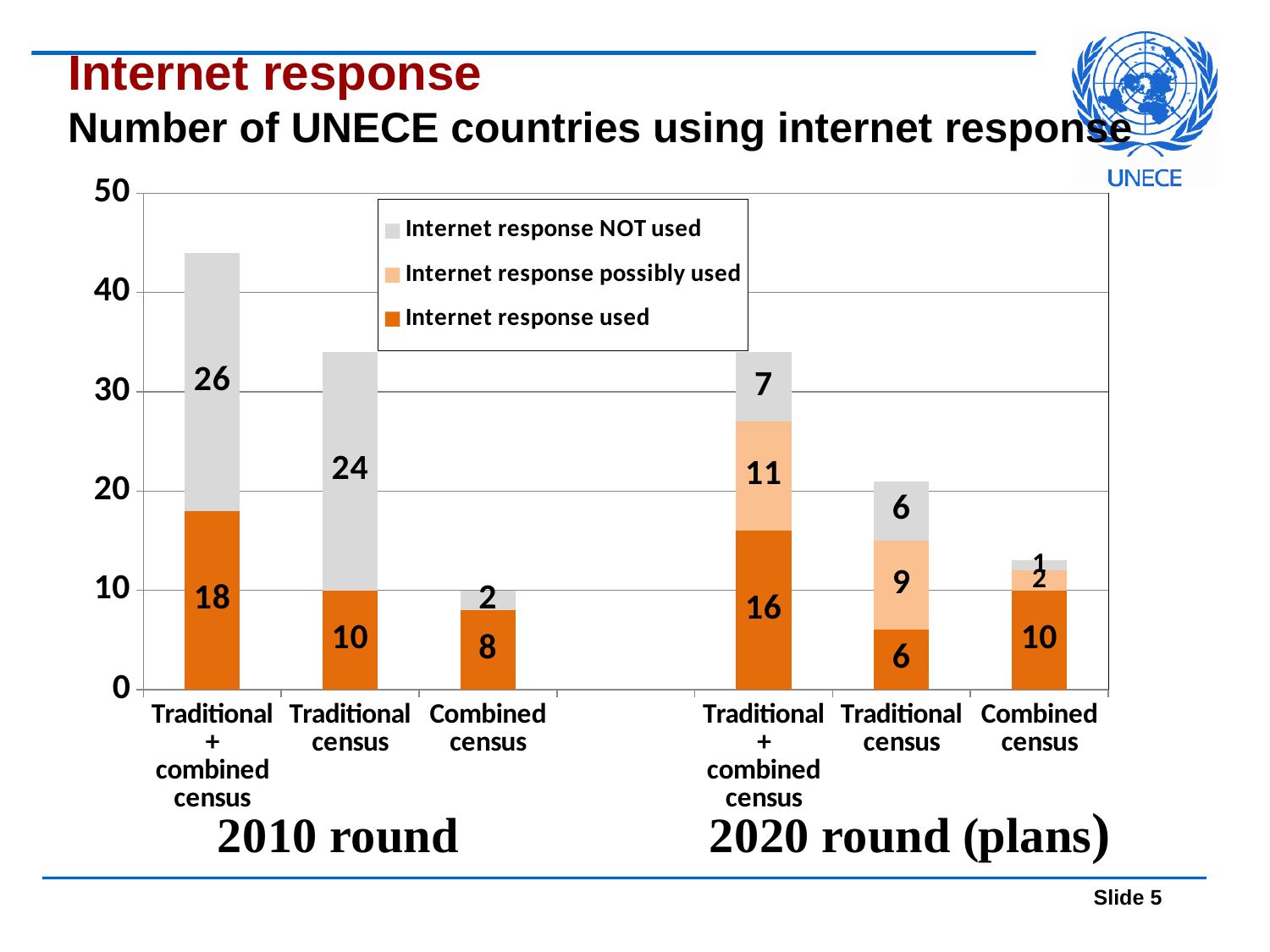
In the 2020 round (plans), how many countries with a Combined census did NOT use internet response? 1 How many series does the legend list? 3 What kind of chart is shown on the slide? stacked bar chart Which is larger: the 'Internet response used' value for Traditional census in the 2010 round or in the 2020 round (plans)? 2010 round In the 2010 round, how many countries with a Traditional + combined census used internet response? 18 What is the difference between the 'Internet response NOT used' values for Traditional + combined census in the 2010 round and the 2020 round (plans)? 19 Which bar has the lowest total across the whole chart? Combined census (2010 round) What is the total height of the 2020 round (plans) Traditional census bar? 21 How many bars are plotted in the chart? 6 In the 2020 round (plans), how many countries with a Traditional + combined census possibly use internet response? 11 In the 2010 round, how many countries with a Traditional census did NOT use internet response? 24 What is the total height of the 2010 round Traditional + combined census bar? 44